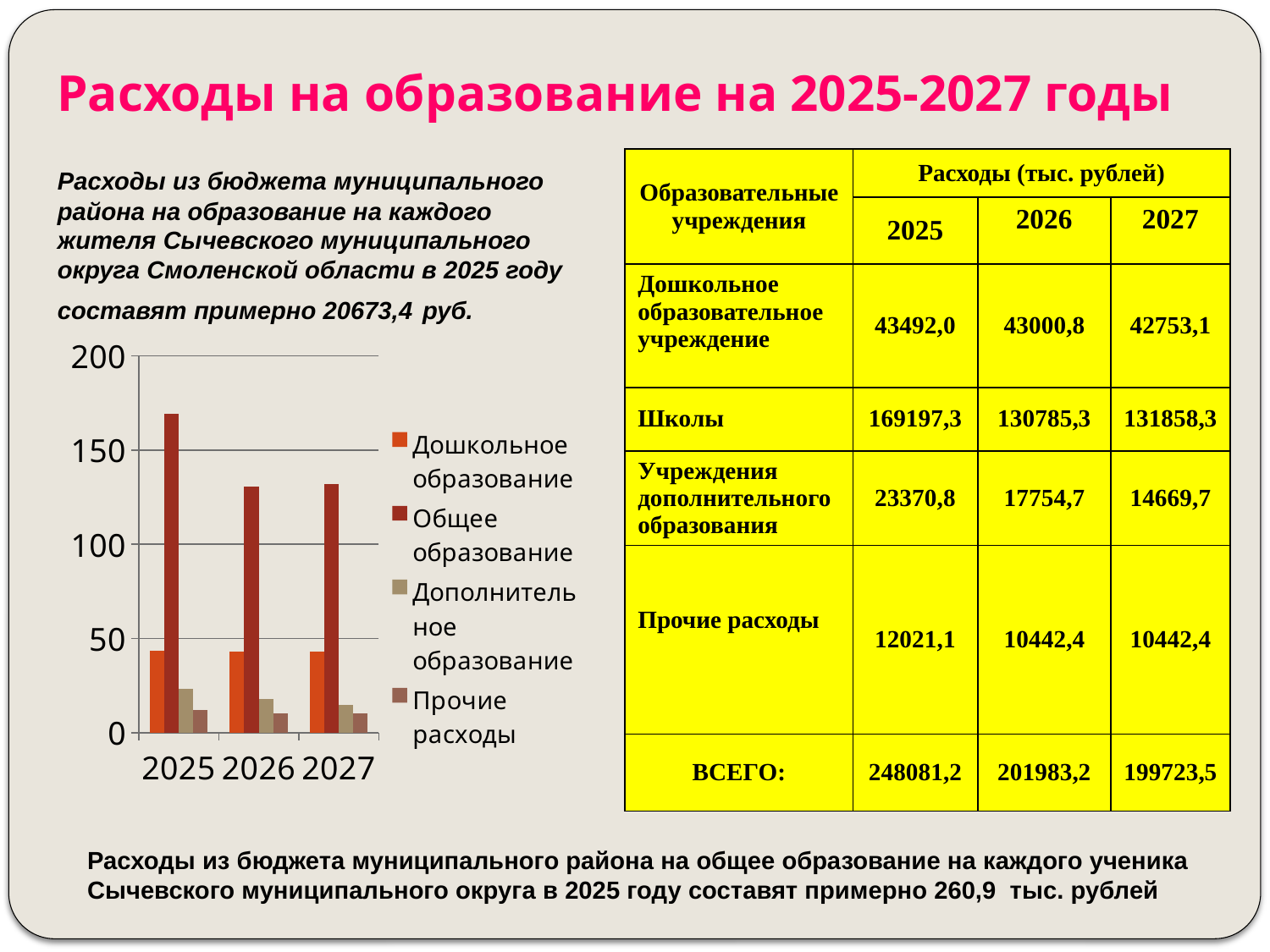
Is the value for Прочие расходы in 2025 greater or less than 50? less Which series has the shortest bar in 2027? Прочие расходы What kind of chart is shown on the slide? bar chart Which series has the tallest bar in 2025? Общее образование How many years are shown on the x axis of the chart? 3 Is the value for Общее образование in 2025 greater or less than 150? greater How many series does the chart legend list? 4 What is the first series listed in the chart legend? Дошкольное образование Is the value for Общее образование in 2026 greater or less than 150? less Which is larger for Общее образование: the 2025 bar or the 2026 bar? 2025 Do the bars for Дополнительное образование rise or fall from 2025 to 2027? fall